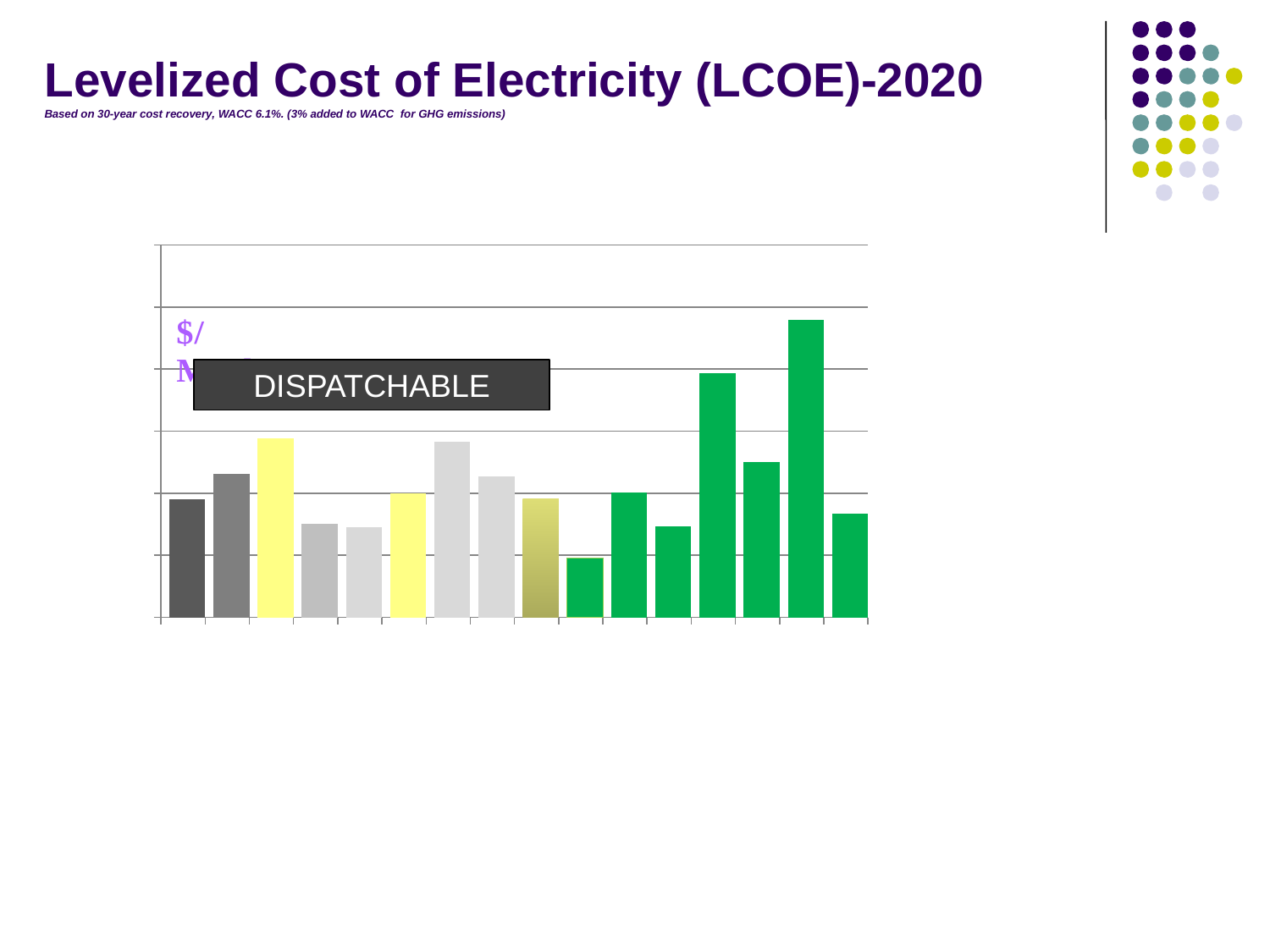
Is the tallest bar in the chart green or grey? green Which bar in the chart is the shortest? the first green bar (tenth bar from the left) Which bar in the chart is the tallest? the second bar from the right Is the second bar from the right taller or shorter than the rightmost bar? taller What kind of chart is shown on the slide? bar chart Is the leftmost bar taller or shorter than the second bar from the left? shorter What word is written in the dark box overlaid on the chart? DISPATCHABLE How many bars are plotted in the chart? 16